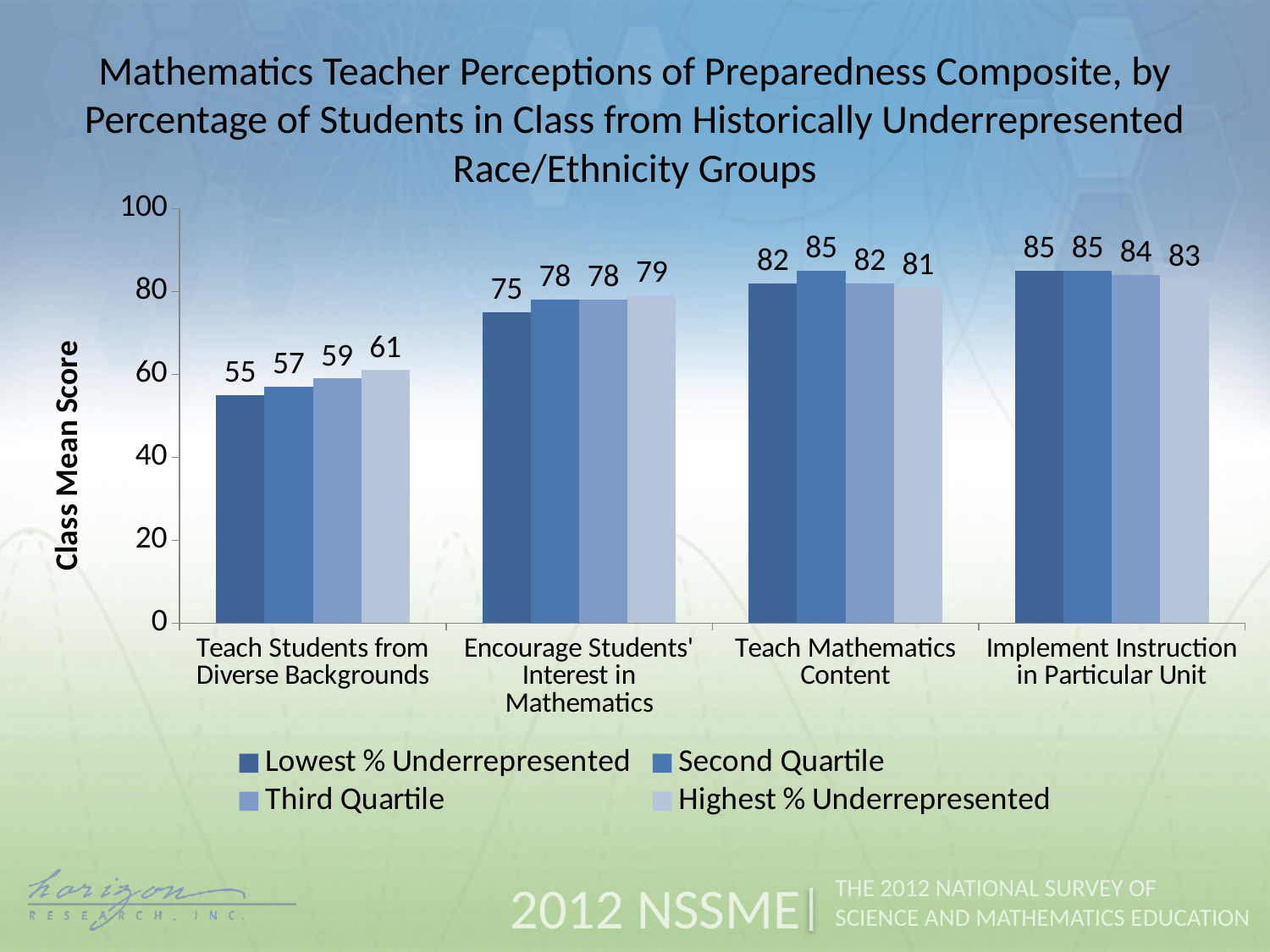
What is the label of the y axis? Class Mean Score Within the Teach Students from Diverse Backgrounds category, which series has the highest Class Mean Score? Highest % Underrepresented What is the Class Mean Score for Highest % Underrepresented in the Encourage Students' Interest in Mathematics category? 79 Which category has the lowest Class Mean Score for the Highest % Underrepresented series? Teach Students from Diverse Backgrounds What is the difference between the Highest % Underrepresented and Lowest % Underrepresented scores in the Teach Students from Diverse Backgrounds category? 6 What is the Class Mean Score for Lowest % Underrepresented in the Teach Students from Diverse Backgrounds category? 55 Which is larger in the Teach Mathematics Content category: the Second Quartile score or the Highest % Underrepresented score? Second Quartile What kind of chart is shown on the slide? Bar chart How many series does the legend list? 4 How many categories are shown on the x axis? 4 What is the Class Mean Score for Second Quartile in the Teach Mathematics Content category? 85 What is the Class Mean Score for Third Quartile in the Implement Instruction in Particular Unit category? 84